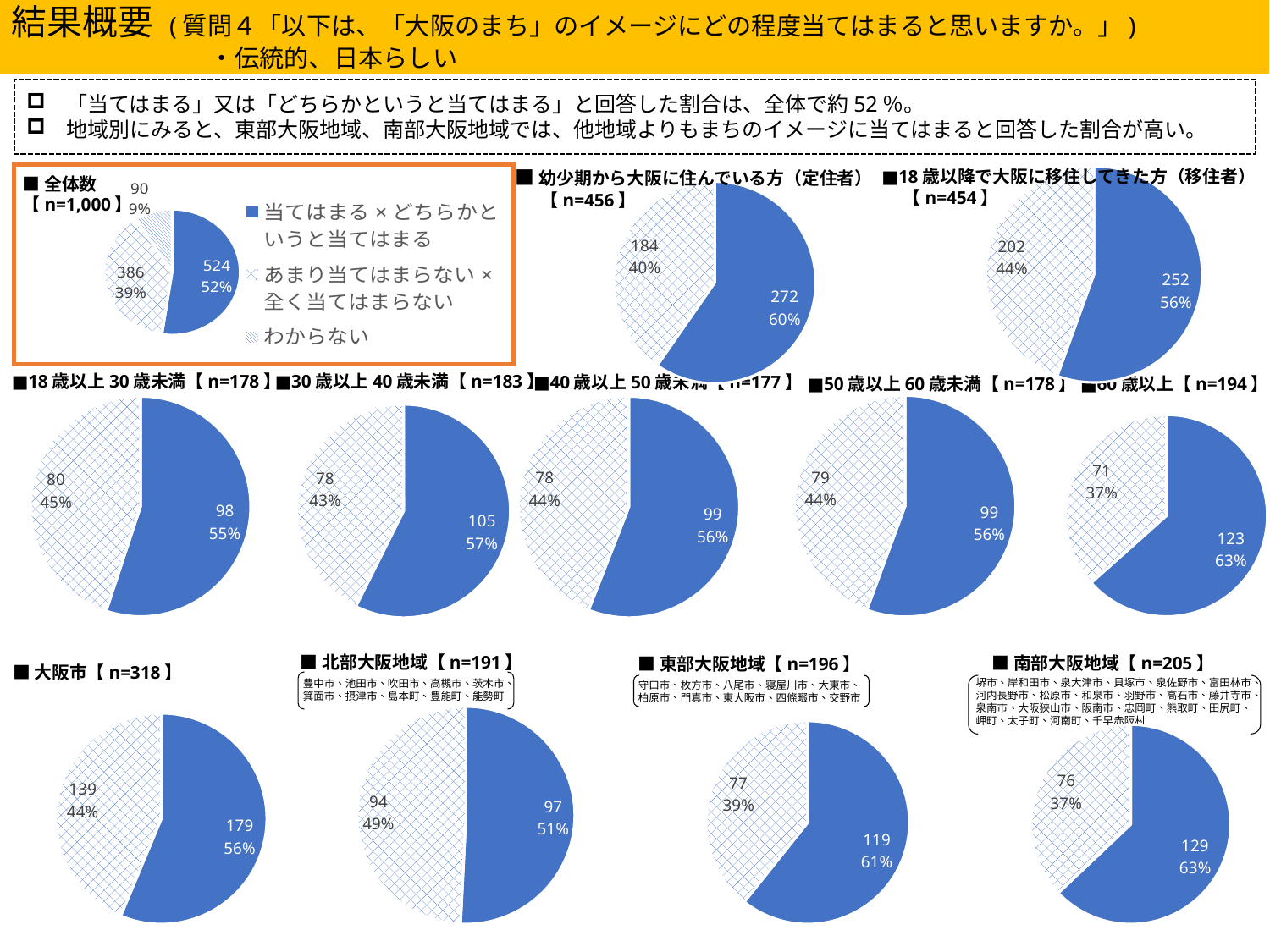
How many pie charts are shown on the slide? 12 In the 東部大阪地域【n=196】 pie chart, what is the value of the hatched (当てはまらない) slice? 77 Which is larger in the 北部大阪地域【n=191】 pie chart: the blue slice (97) or the hatched slice (94)? the blue slice (97) In the 南部大阪地域【n=205】 pie chart, what percentage is the blue (当てはまる) slice? 63% In the 幼少期から大阪に住んでいる方（定住者）【n=456】 pie chart, what is the value of the blue (当てはまる) slice? 272 In the 全体数【n=1,000】 pie chart, what share does わからない have? 9% In the 18歳以降で大阪に移住してきた方（移住者）【n=454】 pie chart, what percentage is the hatched (当てはまらない) slice? 44% In the 60歳以上【n=194】 pie chart, what is the difference between the blue slice value and the hatched slice value? 52 In the 全体数【n=1,000】 pie chart, which slice is the smallest? わからない How many entries does the legend of the 全体数【n=1,000】 pie chart list? 3 What kind of chart is used for the 全体数【n=1,000】 data? pie chart In the 全体数【n=1,000】 pie chart, what is the value for 当てはまる×どちらかというと当てはまる? 524